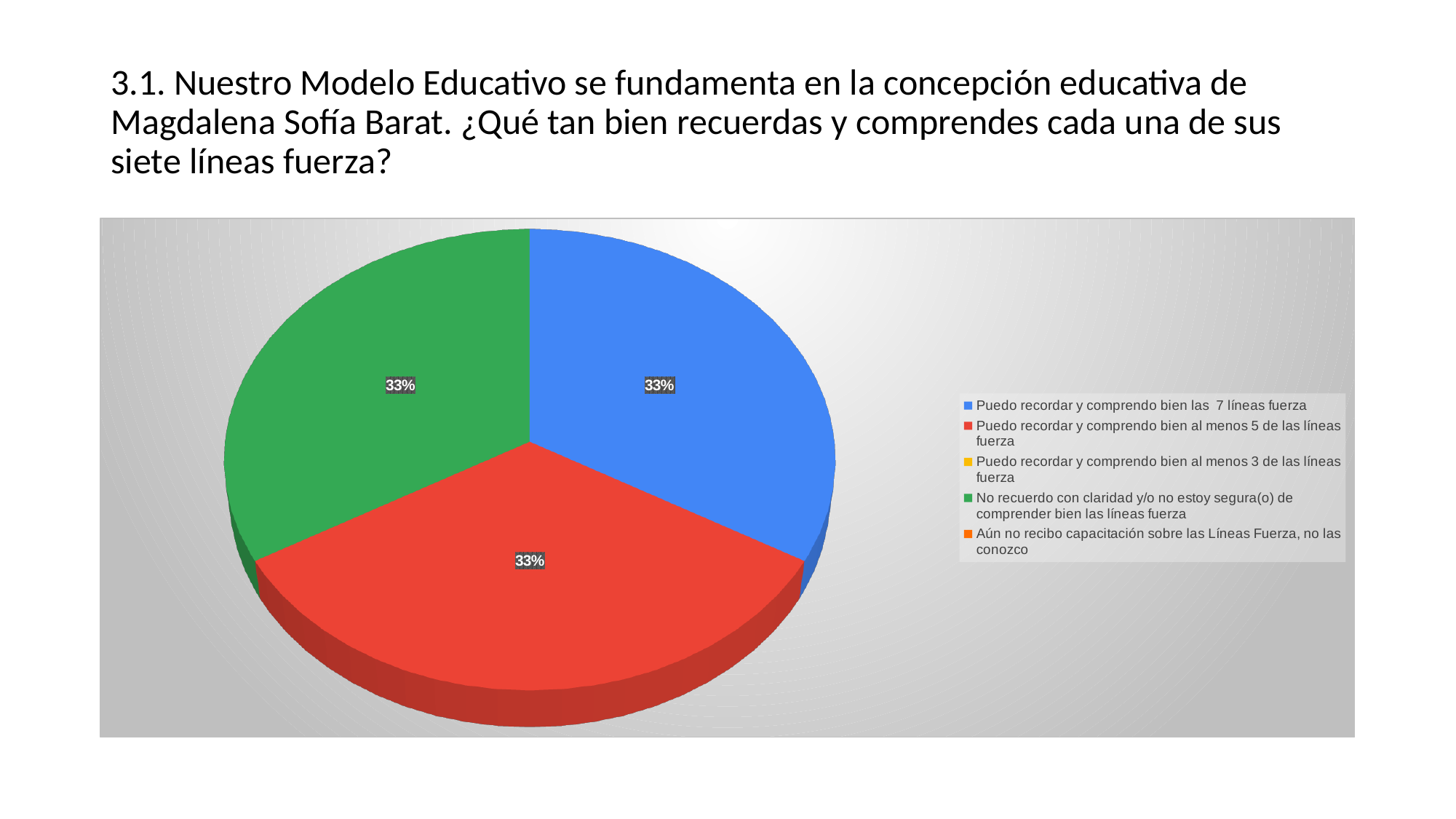
Which legend entry is represented by the green slice? No recuerdo con claridad y/o no estoy segura(o) de comprender bien las líneas fuerza How many entries does the legend list? 5 What percentage is shown for the slice "Puedo recordar y comprendo bien las 7 líneas fuerza"? 33% What is the difference between the share for "Puedo recordar y comprendo bien al menos 5 de las líneas fuerza" and the share for "Puedo recordar y comprendo bien las 7 líneas fuerza"? 0% What percentage is shown for the slice "Puedo recordar y comprendo bien al menos 5 de las líneas fuerza"? 33% Is the share for "Puedo recordar y comprendo bien las 7 líneas fuerza" larger than, smaller than, or equal to the share for "No recuerdo con claridad y/o no estoy segura(o) de comprender bien las líneas fuerza"? Equal Which colour represents "Puedo recordar y comprendo bien al menos 5 de las líneas fuerza" in the legend? Red How many slices with data labels are visible in the pie chart? 3 What percentage is shown for the slice "No recuerdo con claridad y/o no estoy segura(o) de comprender bien las líneas fuerza"? 33% What kind of chart is shown on the slide? Pie chart